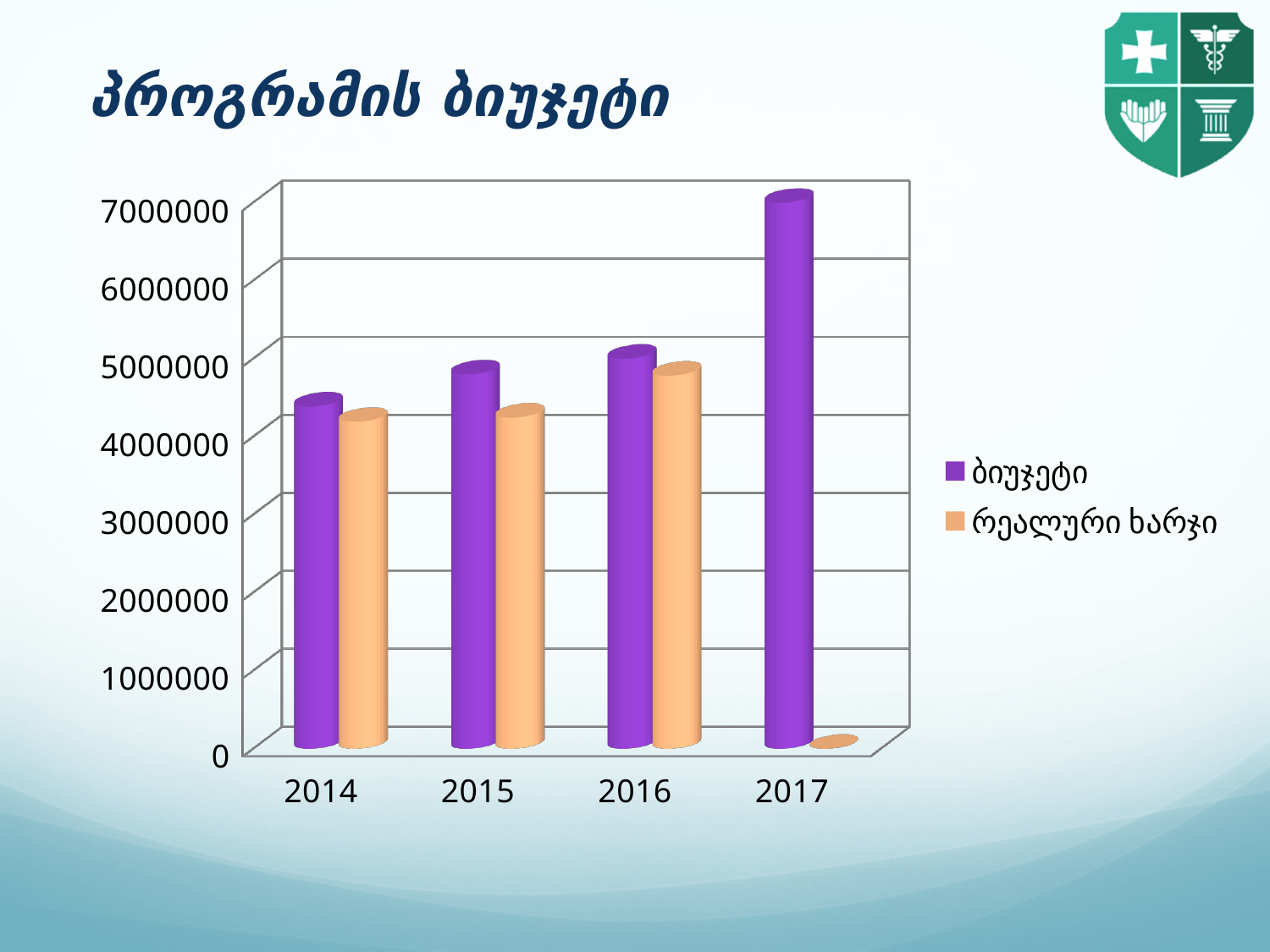
Which is larger, the ბიუჯეტი value for 2017 or the ბიუჯეტი value for 2016? 2017 How many series does the chart's legend list? 2 Is the ბიუჯეტი value for 2014 greater or less than 4000000? greater Is the ბიუჯეტი value for 2017 greater or less than 6000000? greater Is the რეალური ხარჯი value for 2017 greater or less than 1000000? less In which year is the რეალური ხარჯი (real expense) value lowest? 2017 What kind of chart is shown on the slide? bar chart In which year is the ბიუჯეტი (budget) value lowest? 2014 How many years are shown on the x axis of the chart? 4 In which year is the ბიუჯეტი (budget) value highest? 2017 What colour represents the ბიუჯეტი series in the chart? purple Does the ბიუჯეტი series rise or fall from 2014 to 2017? rise